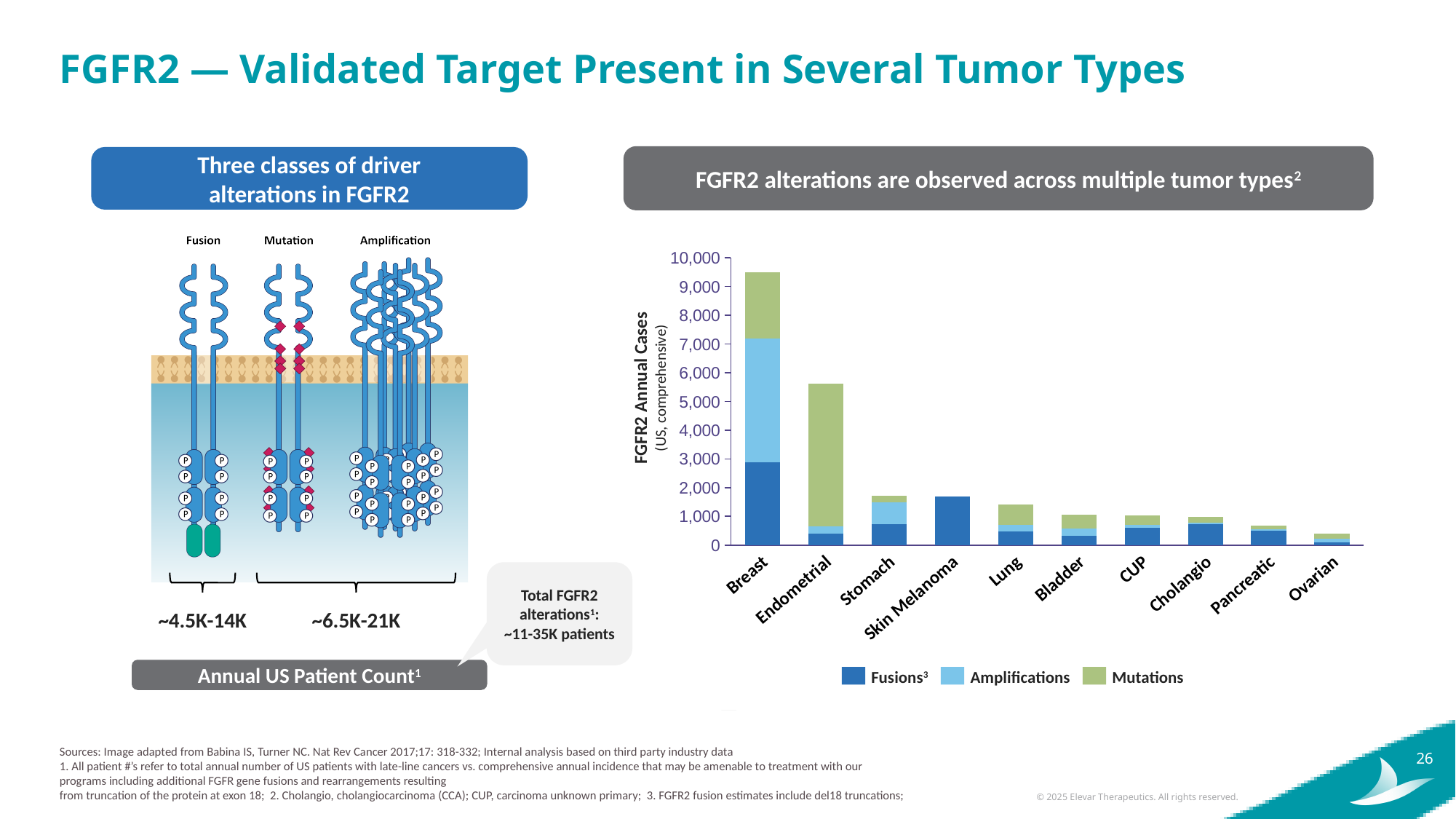
Which tumor type has the highest total FGFR2 annual cases in the chart? Breast Which tumor type has the lowest total FGFR2 annual cases in the chart? Ovarian What kind of chart is shown on the right side of the slide? Stacked bar chart Is the total value for Breast greater or less than 9,000? greater Is the total value for Pancreatic greater or less than 1,000? less What is the label of the y axis on the FGFR2 annual cases chart? FGFR2 Annual Cases (US, comprehensive) How many tumor types are shown on the x axis of the FGFR2 annual cases chart? 10 How many series does the legend of the FGFR2 annual cases chart list? 3 Do the total FGFR2 annual cases generally rise or fall moving from left to right along the x axis? Fall Is the total value for Endometrial greater or less than 5,000? greater Which has more total FGFR2 annual cases, Breast or Endometrial? Breast